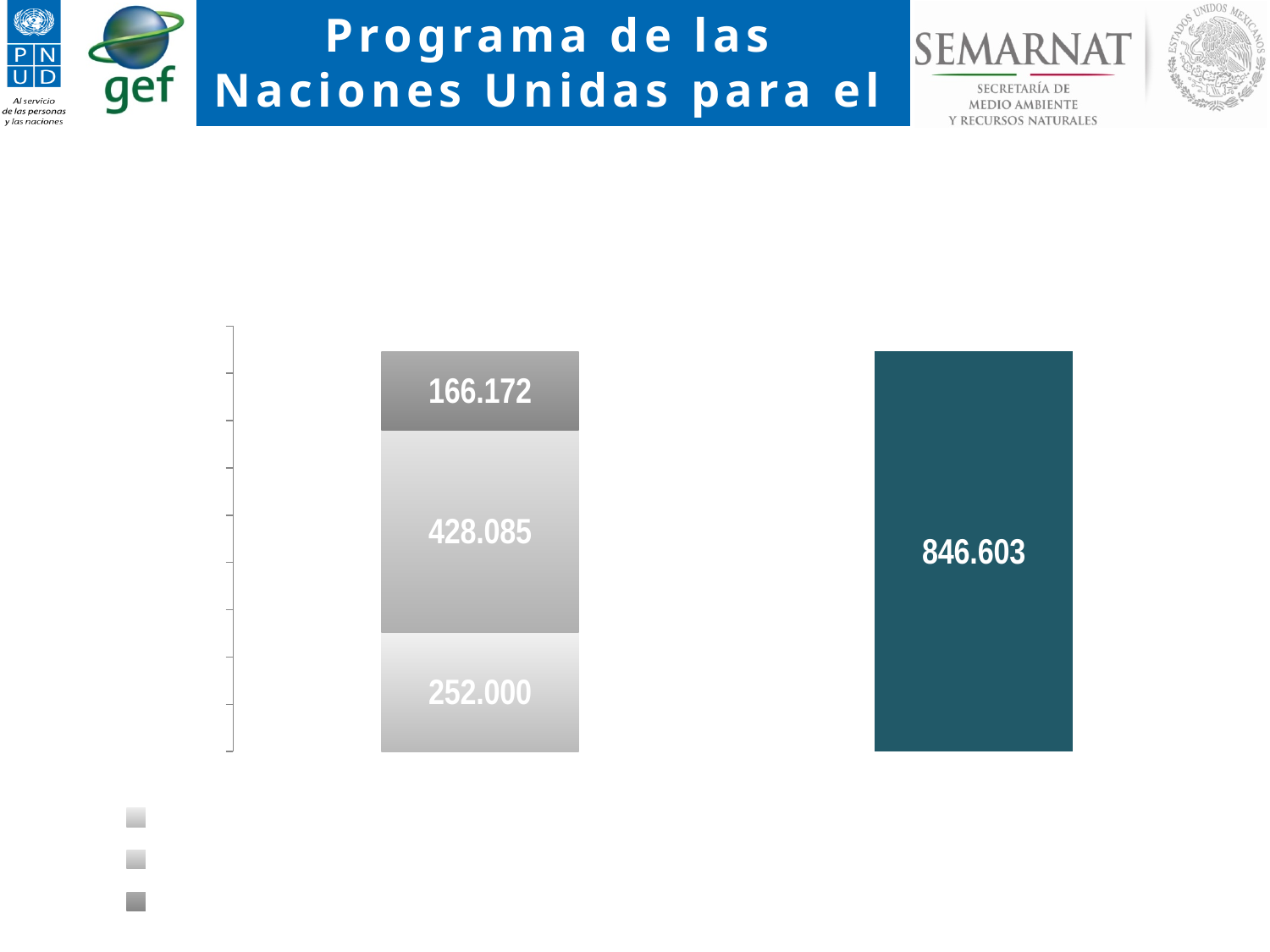
Which segment of the left-hand stacked bar has the largest value? the middle segment (428.085) What value is labelled on the top segment of the left-hand stacked bar? 166.172 What is the difference between the middle segment (428.085) and the bottom segment (252.000) of the left-hand bar? 176.085 What kind of chart is shown on the slide? bar chart What value is labelled on the bottom segment of the left-hand stacked bar? 252.000 How many colour swatches does the legend below the chart show? 3 What is the total of the three segments in the left-hand stacked bar? 846.257 What value is labelled on the middle segment of the left-hand stacked bar? 428.085 How many bars are plotted in the chart? 2 What value is labelled on the right-hand (teal) bar? 846.603 Which segment of the left-hand stacked bar has the smallest value? the top segment (166.172) How many segments make up the left-hand stacked bar? 3